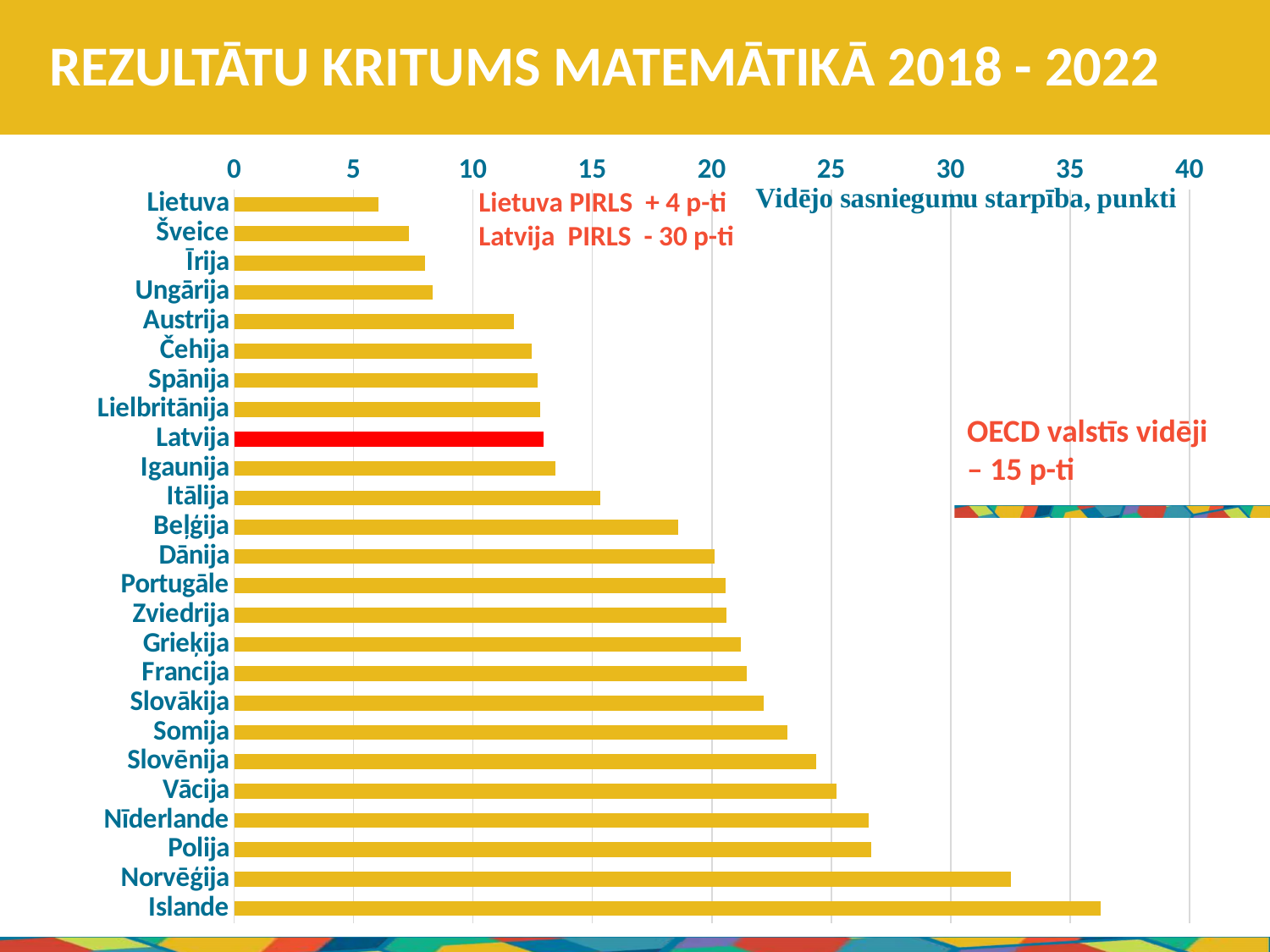
What is the title of the slide? REZULTĀTU KRITUMS MATEMĀTIKĀ 2018 - 2022 Which country has the longest bar in the chart? Islande How many countries are listed in the chart? 25 Is the value for Beļģija greater or less than 20? less Is the value for Somija greater or less than 25? less Which bar is highlighted in red in the chart? Latvija Is the value for Latvija greater or less than 15? less Which has the larger value, Norvēģija or Islande? Islande Which country has the shortest bar in the chart? Lietuva What kind of chart is shown on the slide? bar chart